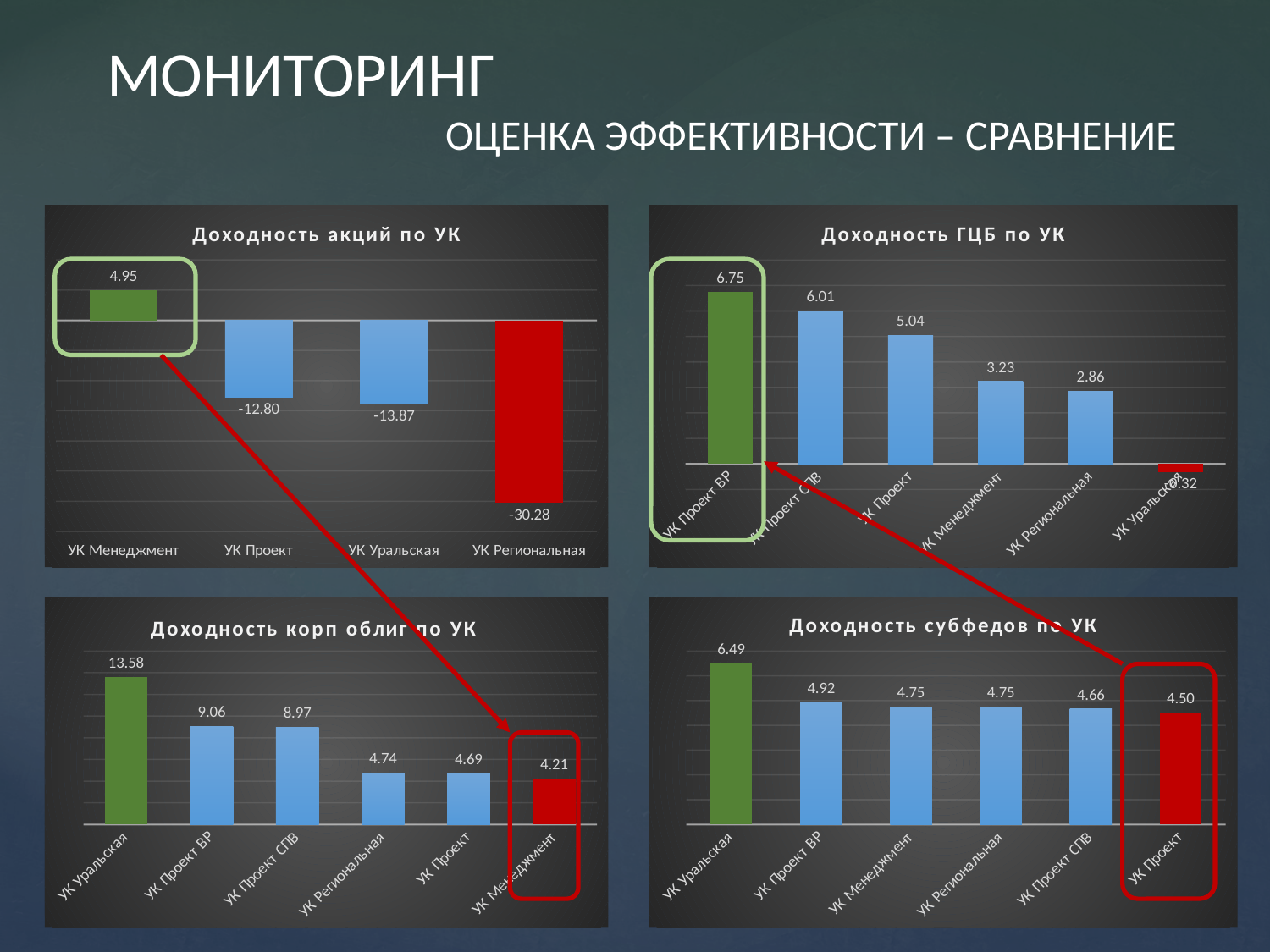
In the chart titled "Доходность ГЦБ по УК", what is the difference between the values for УК Проект ВР and УК Менеджмент? 3.52 In the chart titled "Доходность субфедов по УК", what is the value for УК Проект? 4.50 In the chart titled "Доходность субфедов по УК", what is the difference between the values for УК Уральская and УК Проект ВР? 1.57 In the chart titled "Доходность корп облиг по УК", how many categories are shown? 6 In the chart titled "Доходность акций по УК", how many categories are shown? 4 In the chart titled "Доходность акций по УК", which category has the highest value? УК Менеджмент In the chart titled "Доходность акций по УК", what is the value for УК Региональная? -30.28 What type of chart is the chart titled "Доходность субфедов по УК"? Bar chart In the chart titled "Доходность ГЦБ по УК", which category has the lowest value? УК Уральская In the chart titled "Доходность корп облиг по УК", what is the value for УК Уральская? 13.58